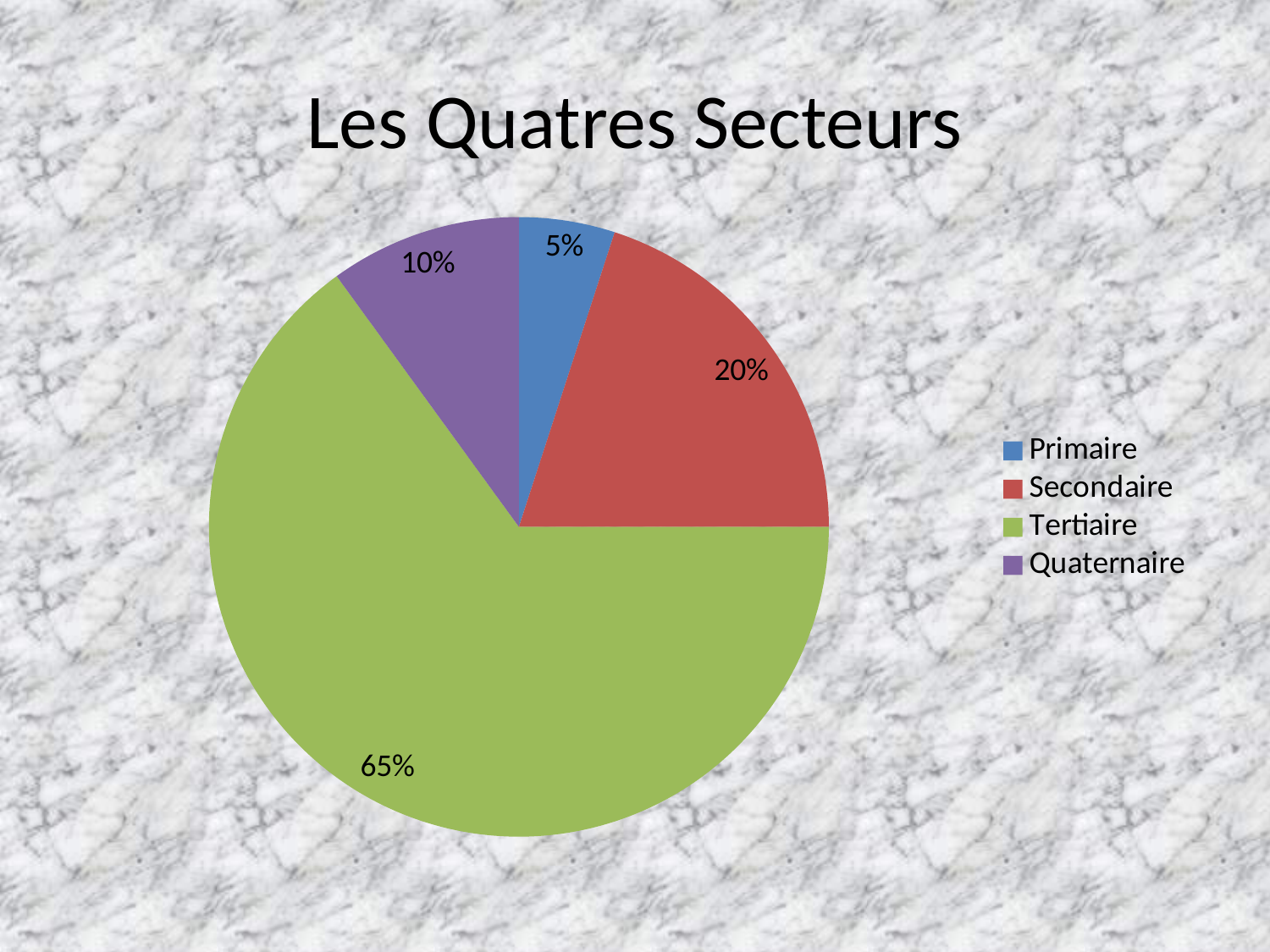
What is the difference in percentage points between the Tertiaire and Secondaire slices? 45 What is the title of the slide? Les Quatres Secteurs What percentage does the Primaire slice represent? 5% What percentage does the Quaternaire slice represent? 10% What percentage does the Tertiaire slice represent? 65% Which is larger, the Secondaire slice or the Quaternaire slice? Secondaire What percentage does the Secondaire slice represent? 20% How many slices does the pie chart have? 4 What kind of chart is shown on the slide? pie chart Which sector has the smallest share of the pie? Primaire How many entries does the legend list? 4 Which sector has the largest share of the pie? Tertiaire